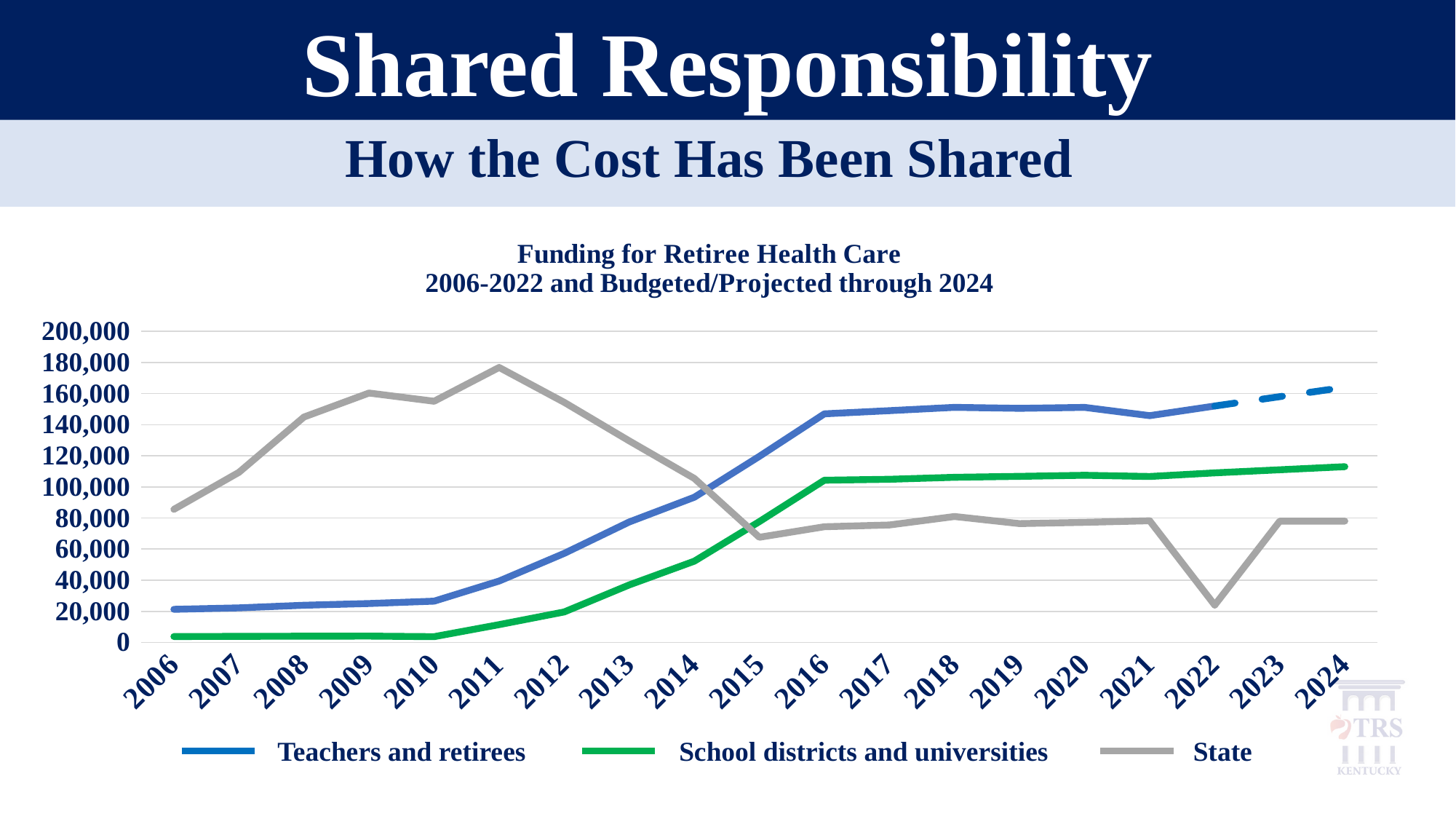
How many series does the legend list? 3 What colour is the State series line? Gray Is the value for State in 2011 greater or less than 160,000? greater What kind of chart is shown on the slide? Line chart In 2006, which is larger: State or Teachers and retirees? State Does the School districts and universities series rise or fall from 2006 to 2024? Rise In 2020, which is larger: Teachers and retirees or State? Teachers and retirees Is the value for School districts and universities in 2024 greater or less than 100,000? greater How many years are shown along the x axis? 19 Is the value for Teachers and retirees in 2006 greater or less than 40,000? less In which year is the State series at its lowest? 2022 In which year is the State series at its highest? 2011